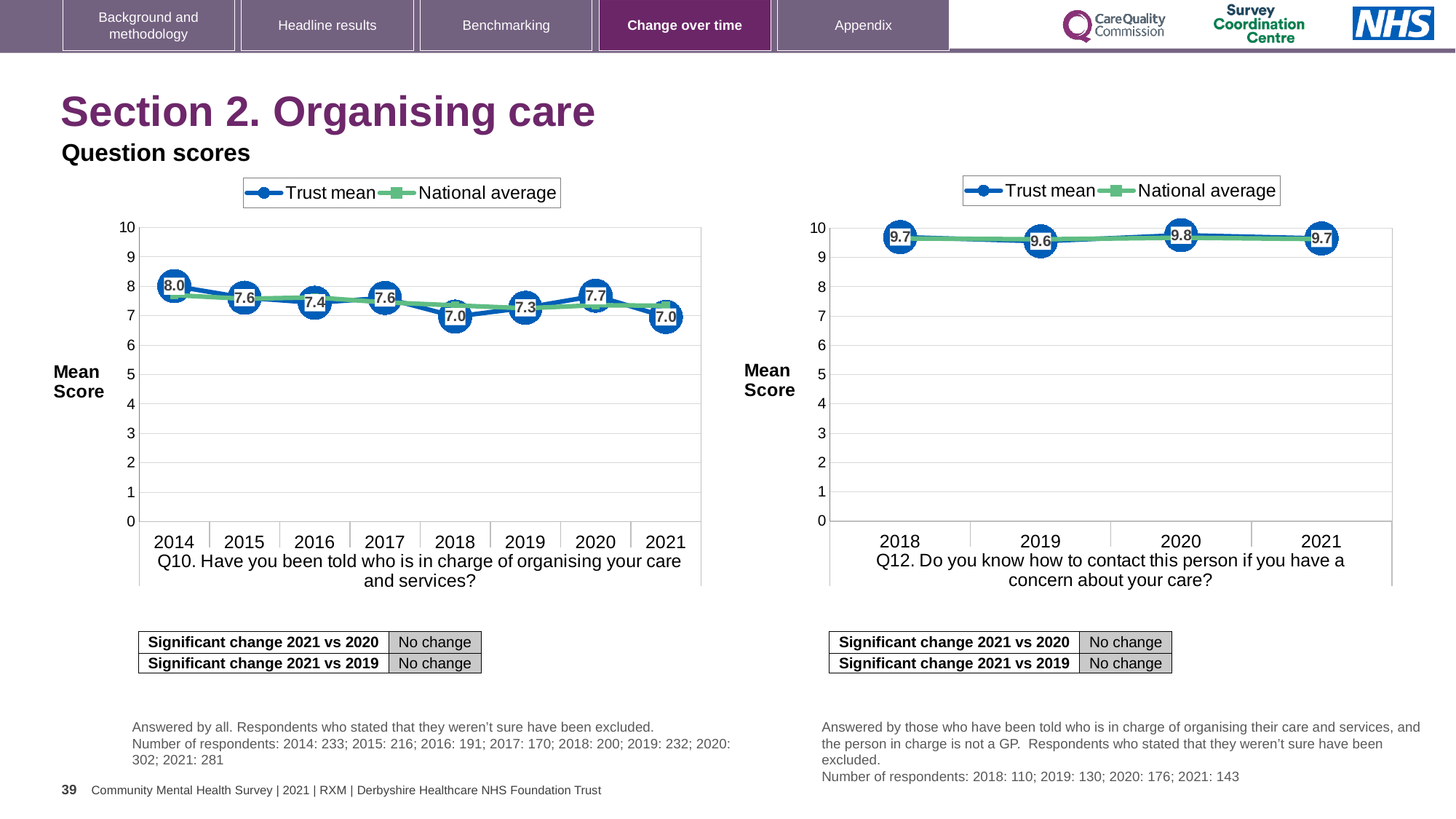
In the Q12 chart on the right, is the Trust mean score for 2019 larger or smaller than the Trust mean score for 2020? smaller In the Q10 chart on the left, how many years are plotted on the x axis? 8 What type of chart is the Q12 chart on the right? Line chart In the Q10 chart on the left, is the Trust mean score for 2020 greater or less than 7? greater In the Q10 chart on the left, which year has the highest Trust mean score? 2014 In the Q10 chart on the left, what is the difference between the Trust mean scores for 2014 and 2021? 1.0 In the Q12 chart on the right, what is the Trust mean score for 2020? 9.8 In the Q10 chart on the left, what is the Trust mean score for 2020? 7.7 In the Q12 chart on the right, how many series does the legend list? 2 In the Q10 chart on the left, what is the Trust mean score for 2021? 7.0 In the Q10 chart on the left, what is the Trust mean score for 2014? 8.0 In the Q12 chart on the right, which year has the lowest Trust mean score? 2019